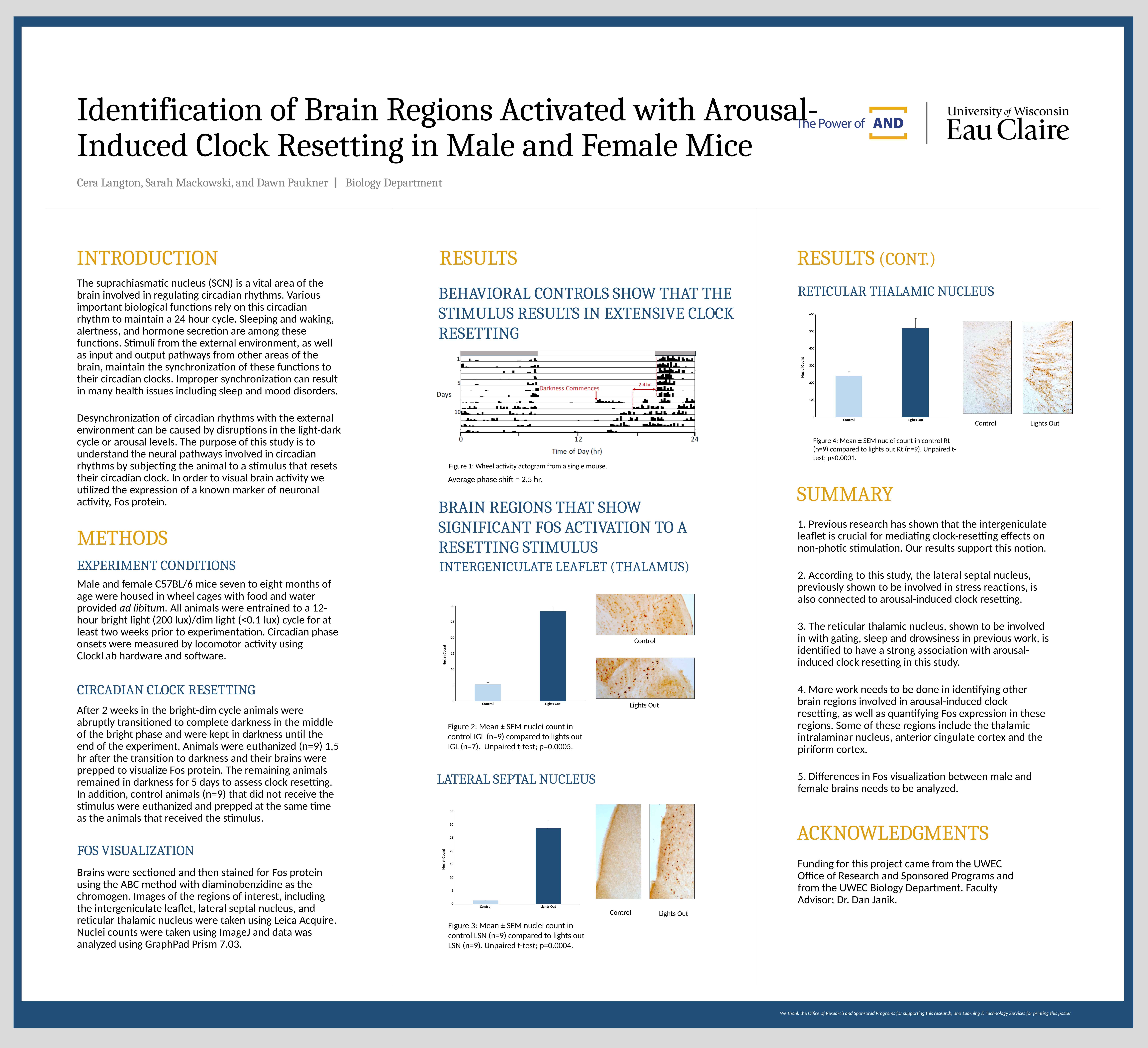
In the Intergeniculate Leaflet (Thalamus) chart, which category has the higher nuclei count? Lights Out What is the y-axis label of the Intergeniculate Leaflet (Thalamus) chart? Nuclei Count In the Lateral Septal Nucleus chart, is the value for Lights Out greater or less than 20? greater In the Intergeniculate Leaflet (Thalamus) chart, is the value for Control greater or less than 10? less In the Lateral Septal Nucleus chart, is the value for Control greater or less than 5? less In the Lateral Septal Nucleus chart, which category has the lower nuclei count? Control In the Reticular Thalamic Nucleus chart, which is larger, Control or Lights Out? Lights Out What kind of chart is the Lateral Septal Nucleus chart? bar chart How many categories are plotted in the Reticular Thalamic Nucleus chart? 2